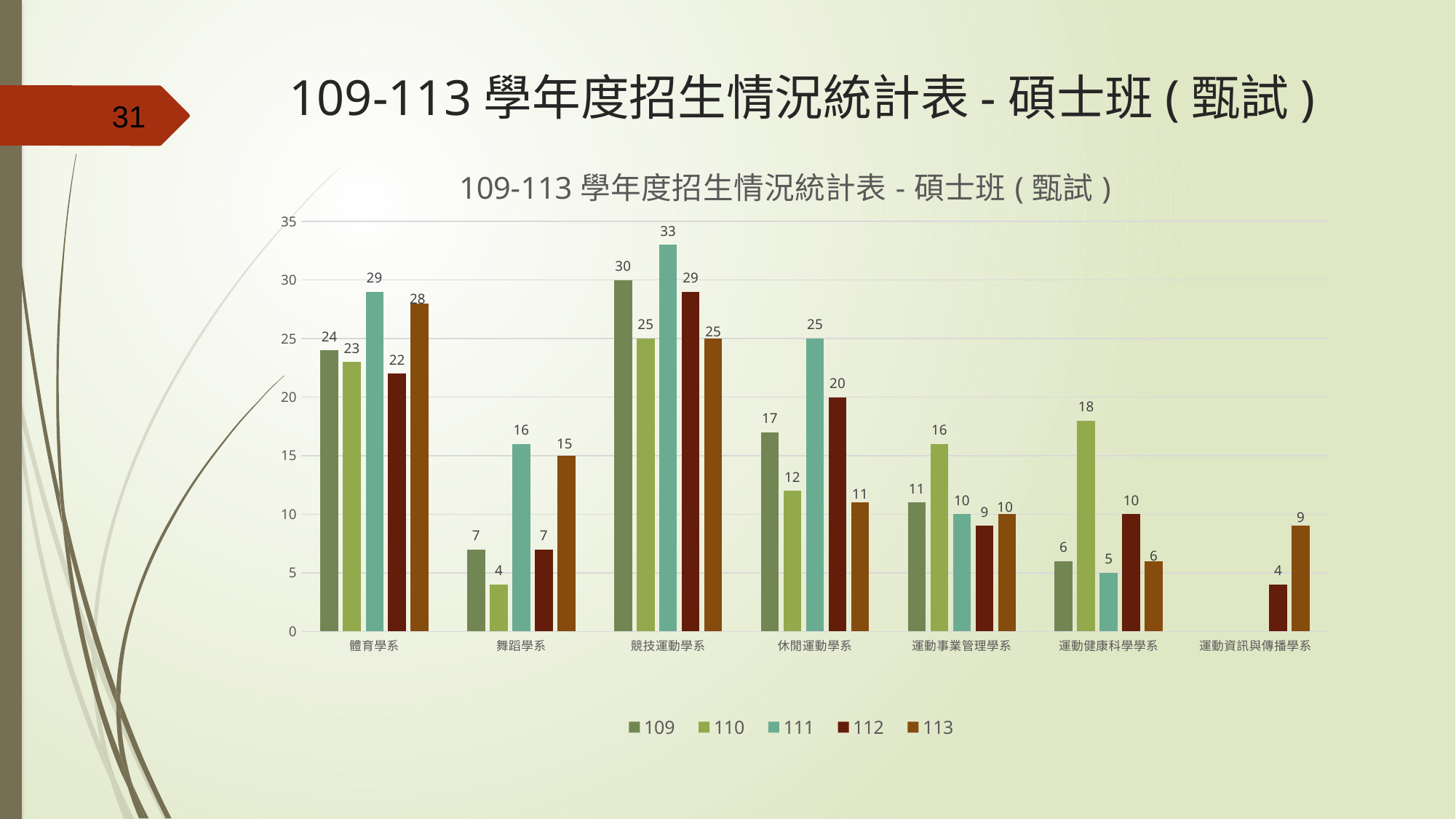
How many series does the legend list? 5 For 運動健康科學學系, which is larger: the value for 110 or the value for 112? 110 What type of chart is shown on the slide? bar chart What is the value for 競技運動學系 in series 111? 33 What is the value for 運動資訊與傳播學系 in series 113? 9 What is the difference between the 111 and 110 values for 休閒運動學系? 13 What is the value for 舞蹈學系 in series 110? 4 What is the title of the chart? 109-113 學年度招生情況統計表 - 碩士班（甄試） Which department has the lowest value in series 109? 運動健康科學學系 What is the difference between the 113 values for 體育學系 and 舞蹈學系? 13 Which department has the highest value in series 111? 競技運動學系 How many departments (categories) are shown on the x axis? 7